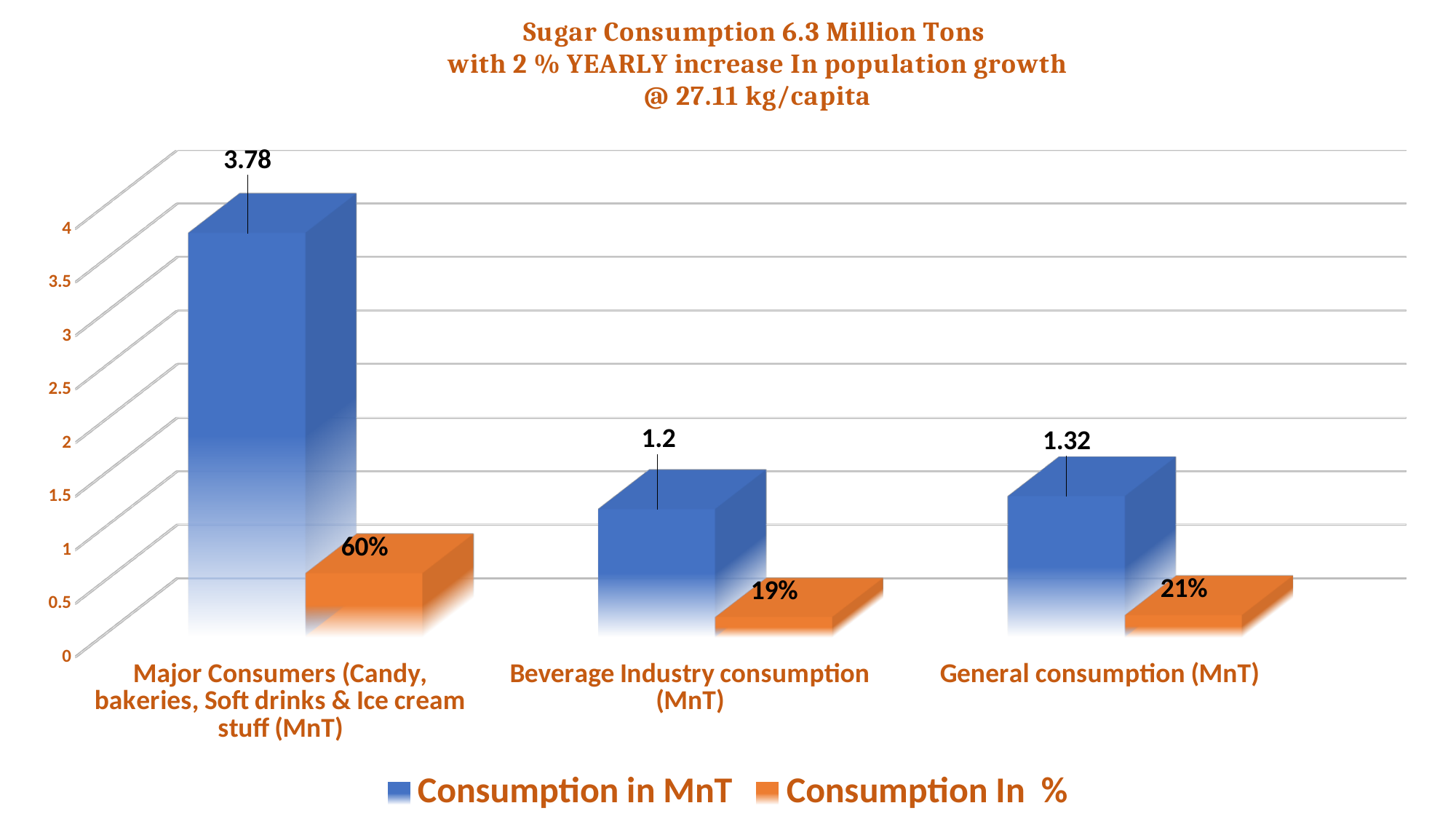
What is the difference in Consumption in MnT between Major Consumers and General consumption? 2.46 What is the Consumption in MnT for Beverage Industry consumption? 1.2 Which category has the highest Consumption in MnT? Major Consumers (Candy, bakeries, Soft drinks & Ice cream stuff) What is the Consumption in MnT for Major Consumers (Candy, bakeries, Soft drinks & Ice cream stuff)? 3.78 What is the Consumption In % for General consumption? 21% How many series does the legend list? 2 What colour represents the Consumption In % series? Orange Which category has the lowest Consumption In %? Beverage Industry consumption Which is larger: the Consumption in MnT for General consumption or for Beverage Industry consumption? General consumption What kind of chart is shown on the slide? Bar chart What is the Consumption In % for Beverage Industry consumption? 19% How many categories are shown on the x axis? 3